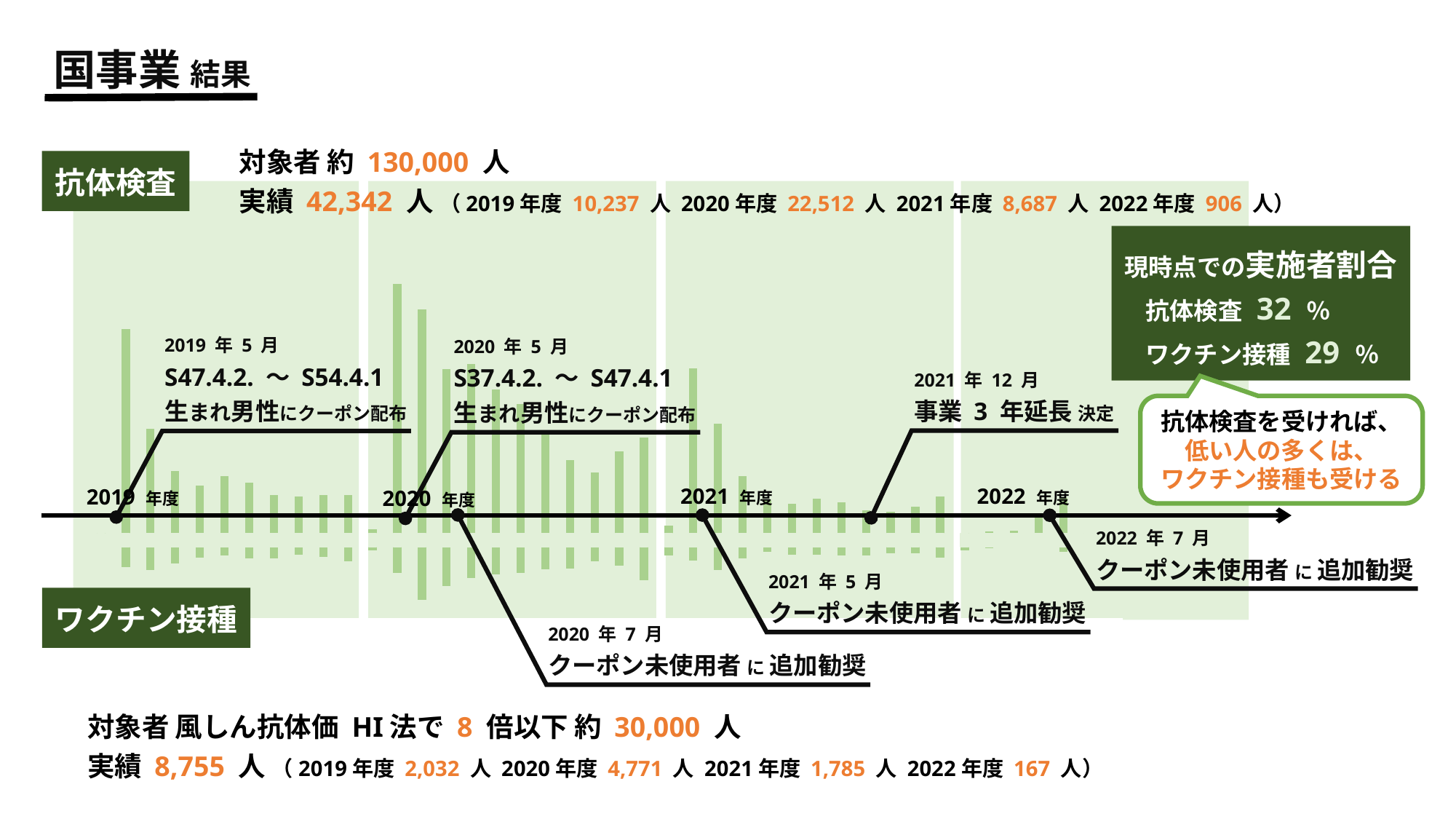
What is the difference between the antibody tests in 2020年度 and 2019年度? 12,275 人 Which fiscal year had the lowest number of vaccinations (ワクチン接種)? 2022年度 What is the total number of vaccinations (ワクチン接種) across the four fiscal years? 8,755 人 How many data series (above and below the timeline) does the bar chart show? 3 Which fiscal year had the highest number of antibody tests (抗体検査)? 2020年度 How many vaccinations (ワクチン接種) were performed in 2021年度? 1,785 人 How many antibody tests (抗体検査) were performed in 2020年度? 22,512 人 What kind of chart is shown behind the timeline on the slide? bar chart Which is larger: vaccinations in 2019年度 or vaccinations in 2021年度? 2019年度 What is the current implementation rate (実施者割合) for antibody testing (抗体検査)? 32 % Do the annual antibody test counts rise or fall from 2020年度 to 2022年度? fall How many antibody tests (抗体検査) were performed in total (実績)? 42,342 人